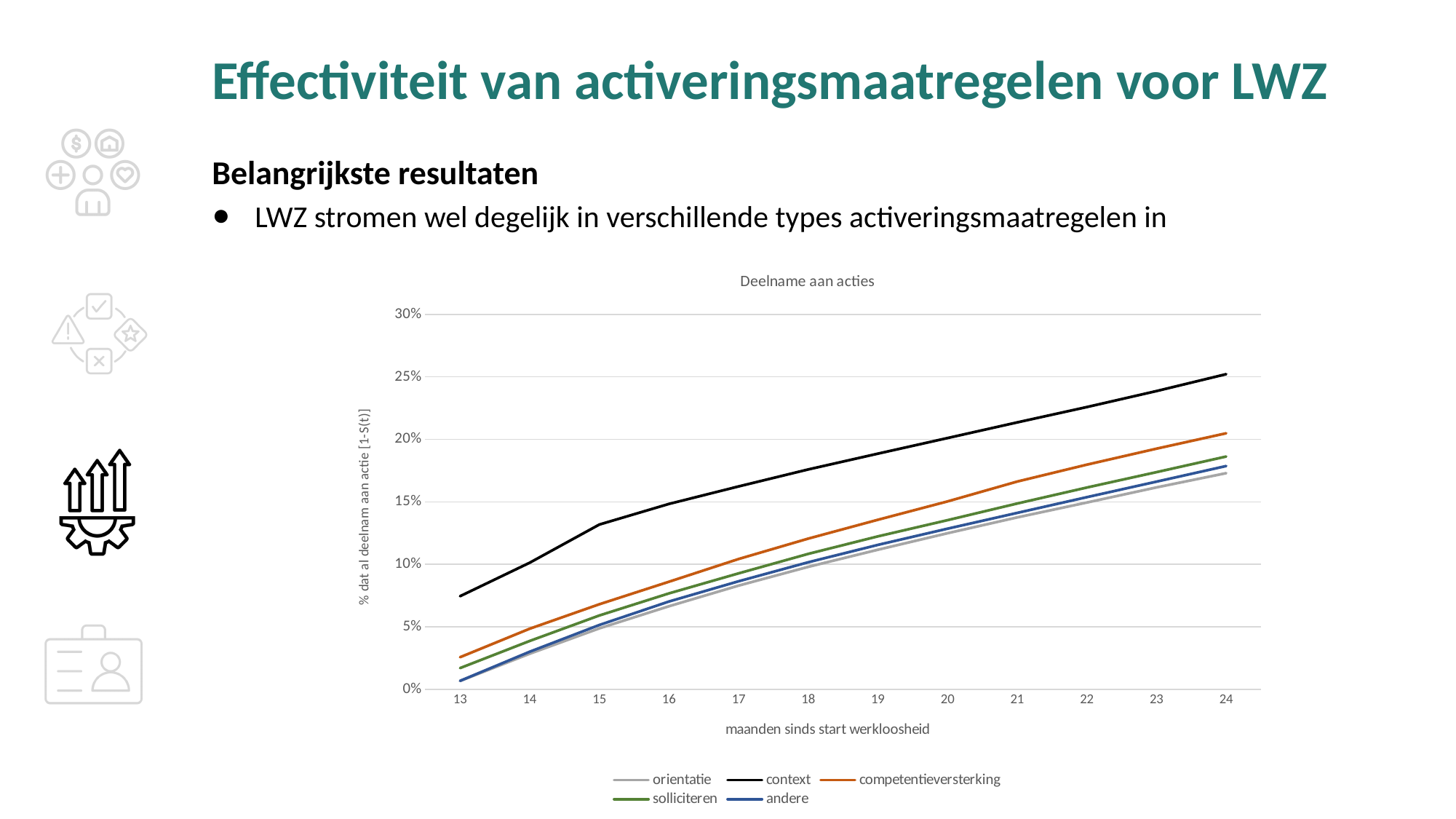
Which series has the highest value at month 24? context Is the value for orientatie at month 13 greater or less than 5%? less What is the label of the x axis of the chart? maanden sinds start werkloosheid What kind of chart is shown on the slide? line chart At month 20, which is larger: the value for context or the value for competentieversterking? context How many points (months) are shown along the x axis of the chart? 12 Do the values of the context series rise or fall as the months increase from 13 to 24? rise Is the value for context at month 13 greater or less than 5%? greater Is the value for solliciteren at month 24 greater or less than 20%? less How many series does the legend of the chart list? 5 What is the title of the chart? Deelname aan acties